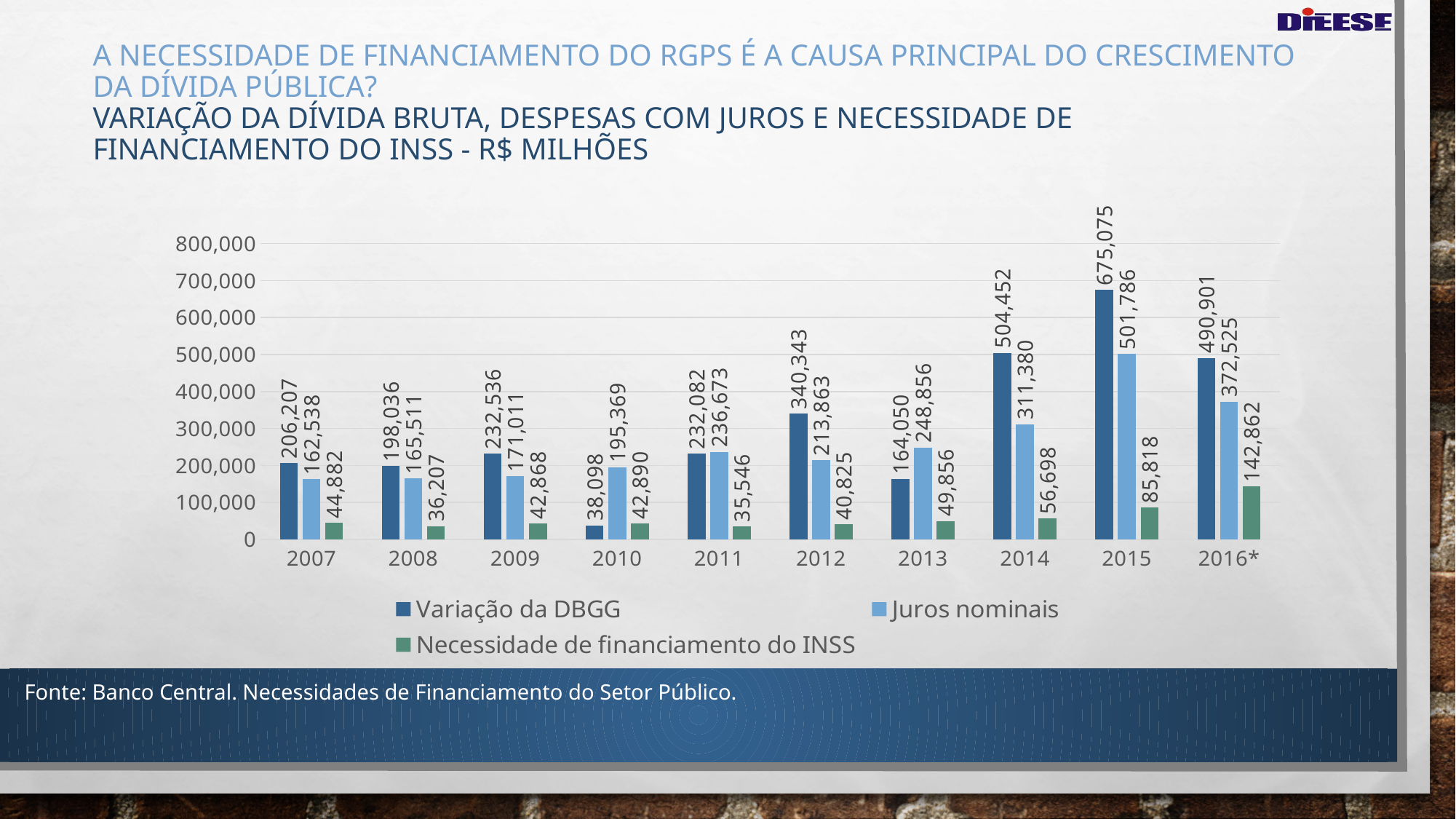
Does Necessidade de financiamento do INSS rise or fall from 2013 to 2016*? Rises In which year is Variação da DBGG the lowest? 2010 How many series does the legend list? 3 What is the value of Variação da DBGG in 2015? 675,075 In which year is Necessidade de financiamento do INSS the highest? 2016* What kind of chart is shown on the slide? Bar chart In which year is Variação da DBGG the highest? 2015 How many years are shown on the x axis? 10 In 2013, which is larger: Variação da DBGG or Juros nominais? Juros nominais What is the difference between Variação da DBGG and Juros nominais in 2015? 173,289 What is the value of Juros nominais in 2011? 236,673 What is the value of Necessidade de financiamento do INSS in 2016*? 142,862